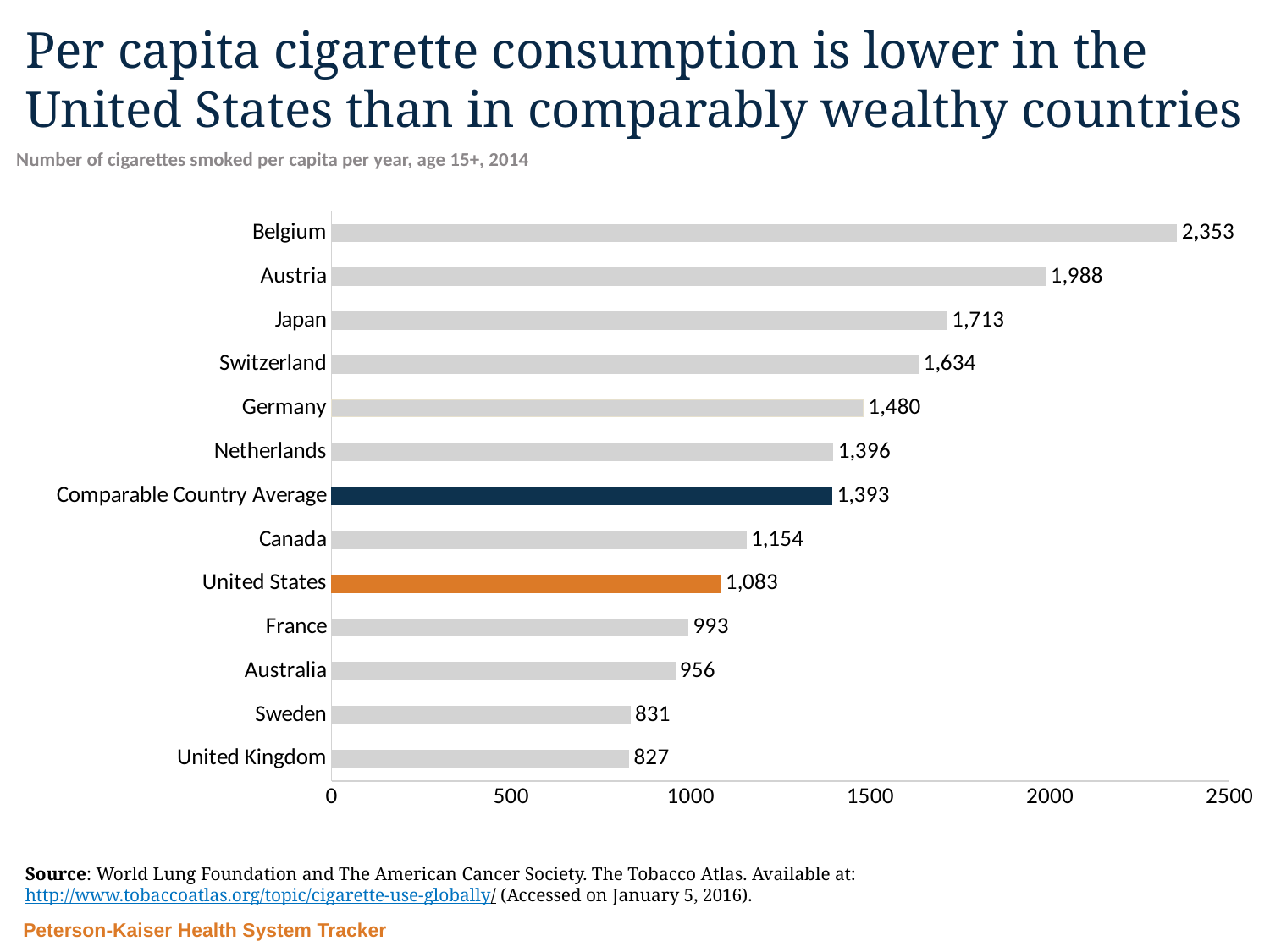
Which country has the highest per capita cigarette consumption on the chart? Belgium What is the difference between Belgium's and Austria's values? 365 How many bars (categories) are shown on the chart? 13 What is the number of cigarettes smoked per capita per year in Belgium? 2,353 Which bar is coloured orange? United States What is the value shown for the United States? 1,083 What is the difference between the Comparable Country Average and the United States value? 310 What kind of chart is shown on the slide? Bar chart Which has a higher value, Japan or Switzerland? Japan What is the value shown for the Comparable Country Average? 1,393 Which country has the lowest per capita cigarette consumption on the chart? United Kingdom Is the value for Germany greater or less than 1500? less